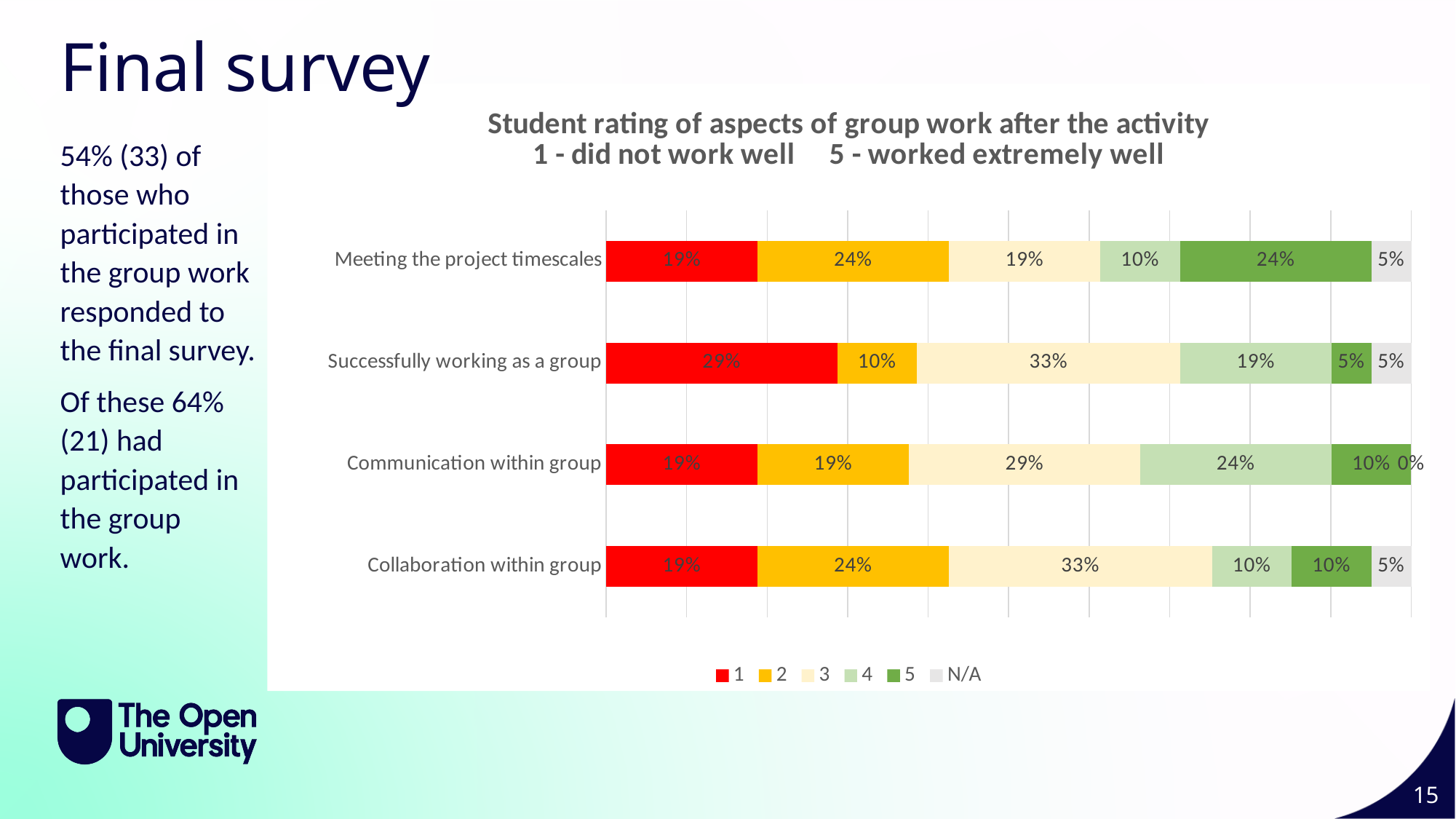
How many aspects of group work are plotted on the chart? 4 What is the title of the chart? Student rating of aspects of group work after the activity 1 - did not work well 5 - worked extremely well Which has a larger rating 4 percentage: 'Communication within group' or 'Collaboration within group'? Communication within group For 'Successfully working as a group', what is the difference between the rating 1 and rating 2 percentages? 19 percentage points What percentage of students answered N/A for 'Communication within group'? 0% How many series does the legend list? 6 What percentage of students gave a rating of 1 for 'Successfully working as a group'? 29% What percentage of students gave a rating of 5 for 'Meeting the project timescales'? 24% Which aspect has the lowest percentage of rating 5 responses? Successfully working as a group What percentage of students gave a rating of 3 for 'Collaboration within group'? 33% Which aspect has the highest percentage of rating 1 responses? Successfully working as a group What type of chart is shown on the slide? Stacked bar chart